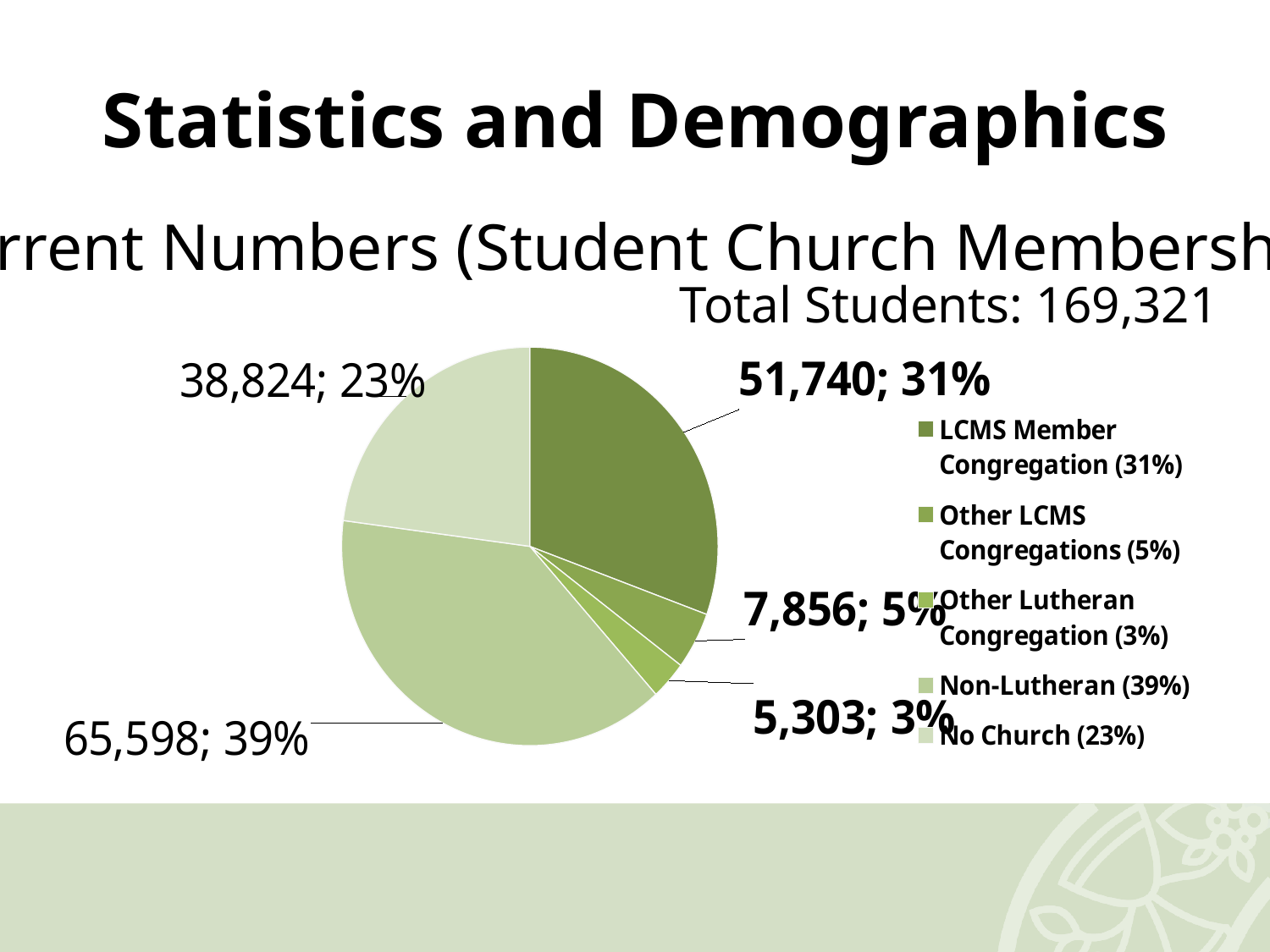
How many slices does the pie chart have? 5 Which category has the largest slice of the pie? Non-Lutheran What is the value for No Church? 38,824 Which is larger, the value for Other LCMS Congregations or the value for Other Lutheran Congregation? Other LCMS Congregations Which category has the smallest slice of the pie? Other Lutheran Congregation What is the difference between the Non-Lutheran value and the LCMS Member Congregation value? 13,858 What share of the pie does No Church represent? 23% What is the value for LCMS Member Congregation? 51,740 How many entries does the legend list? 5 What type of chart is shown on the slide? pie chart What is the value for Non-Lutheran? 65,598 What is the value for Other LCMS Congregations? 7,856